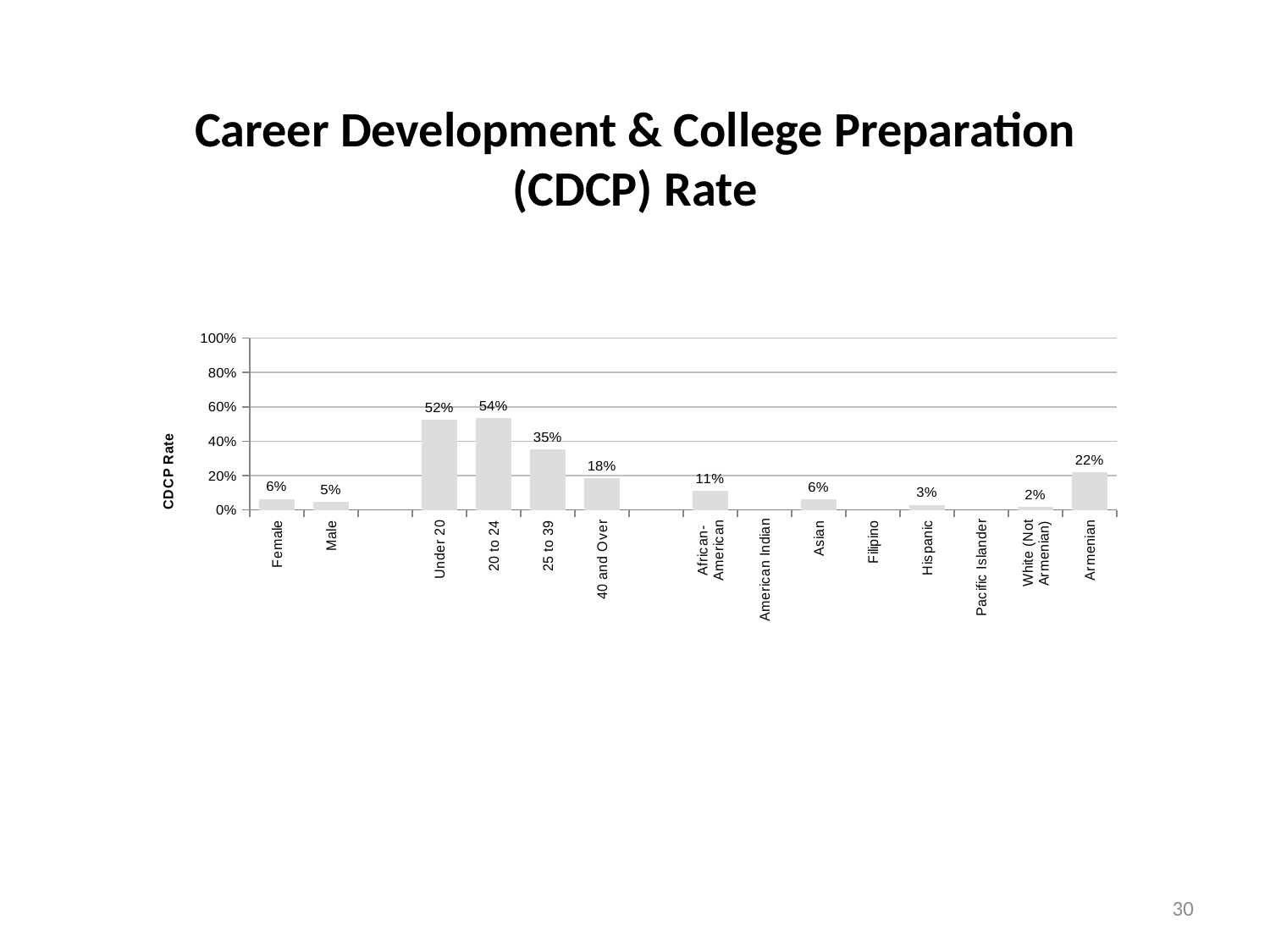
What is the difference between the CDCP rates for Under 20 and 40 and Over? 34% What is the difference between the CDCP rates for Armenian and White (Not Armenian)? 20% What kind of chart is shown on the slide? bar chart What is the CDCP rate for Female? 6% What is the CDCP rate for Armenian? 22% Which category has the highest CDCP rate? 20 to 24 What is the CDCP rate for Hispanic? 3% Which age group has the lowest CDCP rate? 40 and Over What is the CDCP rate for the 25 to 39 age group? 35% Is the CDCP rate for 20 to 24 greater or less than 40%? greater What is the title of the chart's vertical axis? CDCP Rate Which has a higher CDCP rate, African-American or Asian? African-American